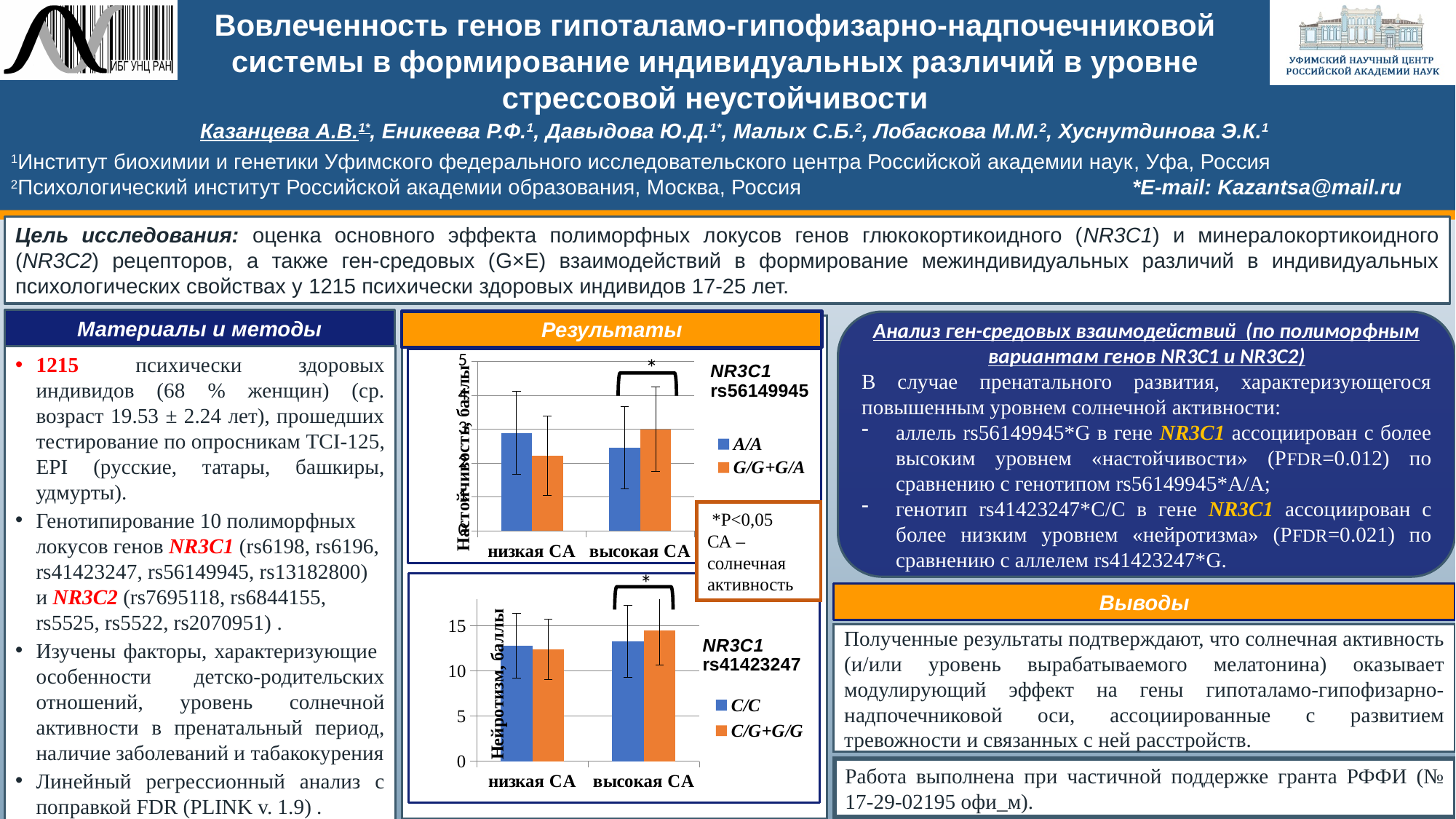
What kind of chart is the bottom chart (NR3C1 rs41423247)? bar chart In the top chart (NR3C1 rs56149945), is the value for A/A at высокая СА greater or less than 4? less What is the y-axis label of the bottom chart (NR3C1 rs41423247)? Нейротизм, баллы What kind of chart is the top chart (NR3C1 rs56149945)? bar chart In the top chart (NR3C1 rs56149945), at низкая СА, which series has the larger value, A/A or G/G+G/A? A/A How many categories are shown on the x axis of the bottom chart (NR3C1 rs41423247)? 2 In the bottom chart (NR3C1 rs41423247), is the value for C/G+G/G at высокая СА greater or less than 10? greater How many series does the legend of the top chart (NR3C1 rs56149945) list? 2 In the bottom chart (NR3C1 rs41423247), is the value for C/C at низкая СА greater or less than 15? less What are the two series listed in the legend of the bottom chart (NR3C1 rs41423247)? C/C and C/G+G/G In the bottom chart (NR3C1 rs41423247), at высокая СА, which series has the larger value, C/C or C/G+G/G? C/G+G/G